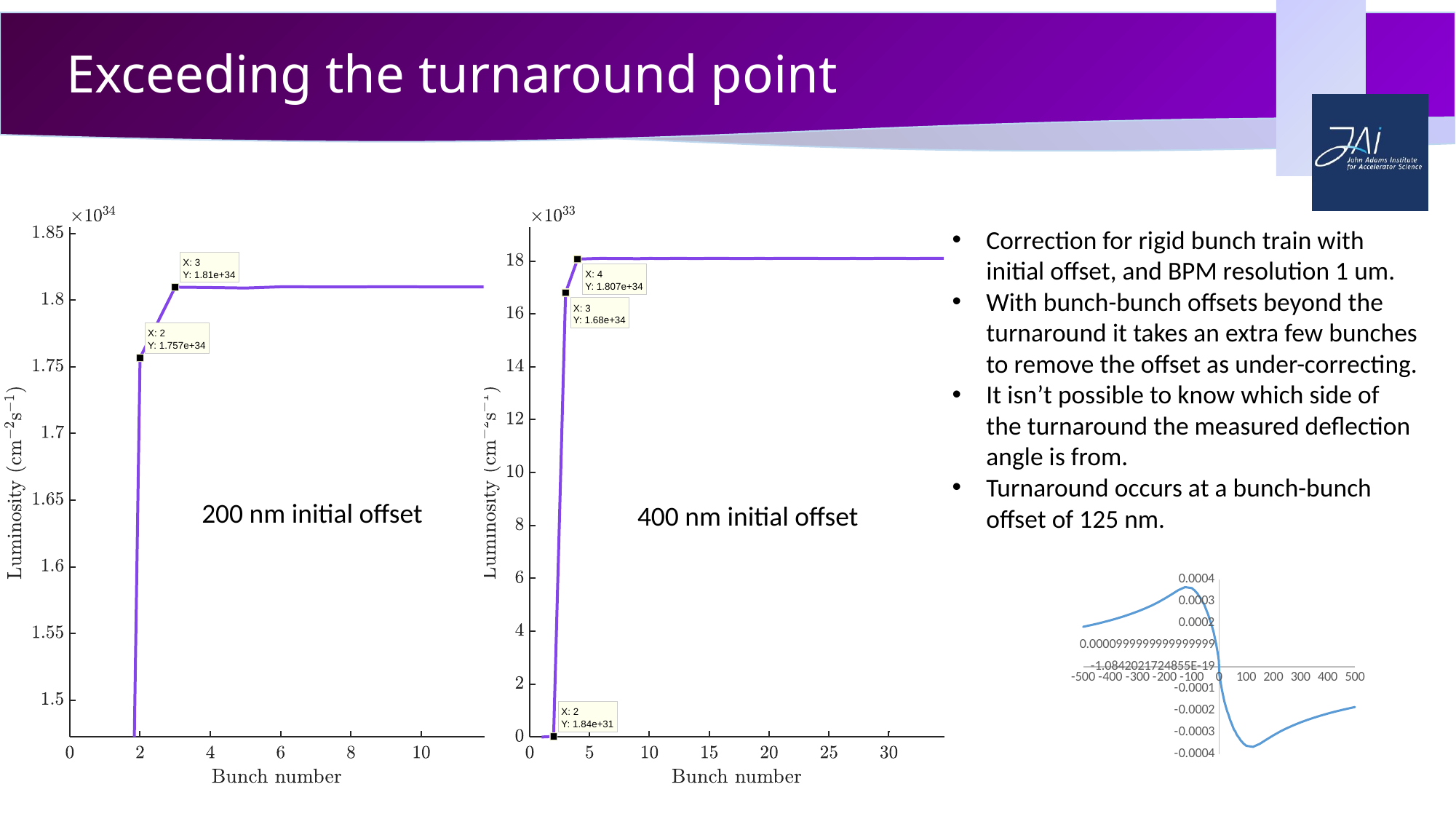
What is the x-axis label of the 200 nm initial offset chart? Bunch number What kind of chart is the small chart at the bottom right of the slide? line chart In the 400 nm initial offset chart, what is the luminosity at bunch number 2? 1.84e+31 In the 400 nm initial offset chart, does the luminosity rise or fall from bunch number 2 to bunch number 4? rise In the 400 nm initial offset chart, what is the luminosity at bunch number 3? 1.68e+34 In the 200 nm initial offset chart, what is the luminosity at bunch number 3? 1.81e+34 In the 400 nm initial offset chart, is the luminosity at bunch number 30 greater or less than 16 on the y axis (×10^33)? greater In the 200 nm initial offset chart, what is the luminosity at bunch number 2? 1.757e+34 How many labelled data points are marked in the 400 nm initial offset chart? 3 In the 200 nm initial offset chart, which has the larger luminosity, bunch number 2 or bunch number 3? bunch number 3 In the 400 nm initial offset chart, what is the luminosity at bunch number 4? 1.807e+34 What kind of chart is the 200 nm initial offset chart? line chart